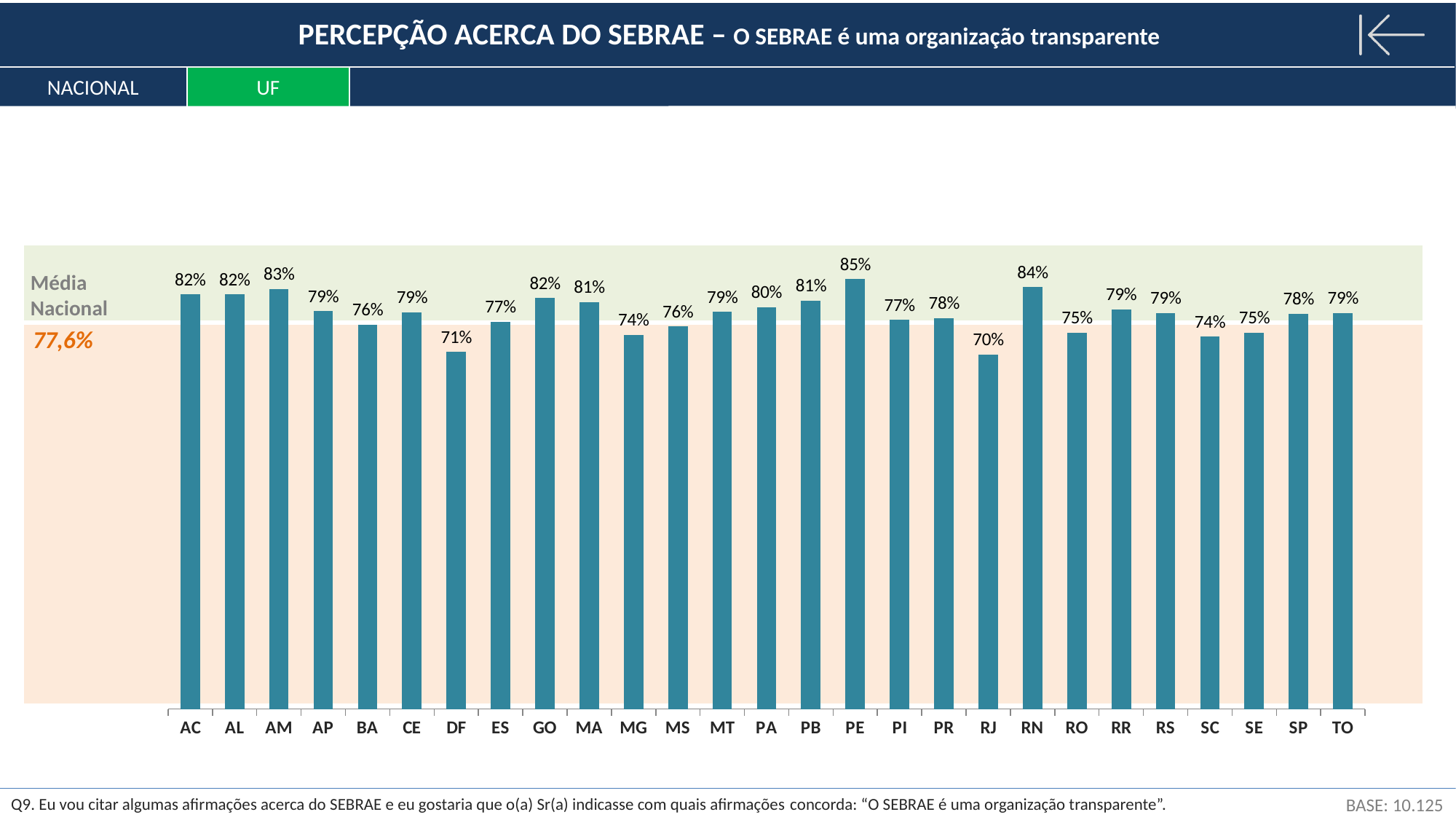
What kind of chart is shown on the slide? Bar chart Which UF has the highest value? PE What is the difference between the values for PE and RJ? 15% What is the value for MG? 74% What is the value for DF? 71% What is the value for PE? 85% Which UF has the lowest value? RJ What is the Média Nacional value shown on the chart? 77,6% How many UFs are shown on the x axis? 27 Which is larger, the value for RN or the value for RO? RN What is the value for SP? 78% What is the difference between the values for AM and BA? 7%